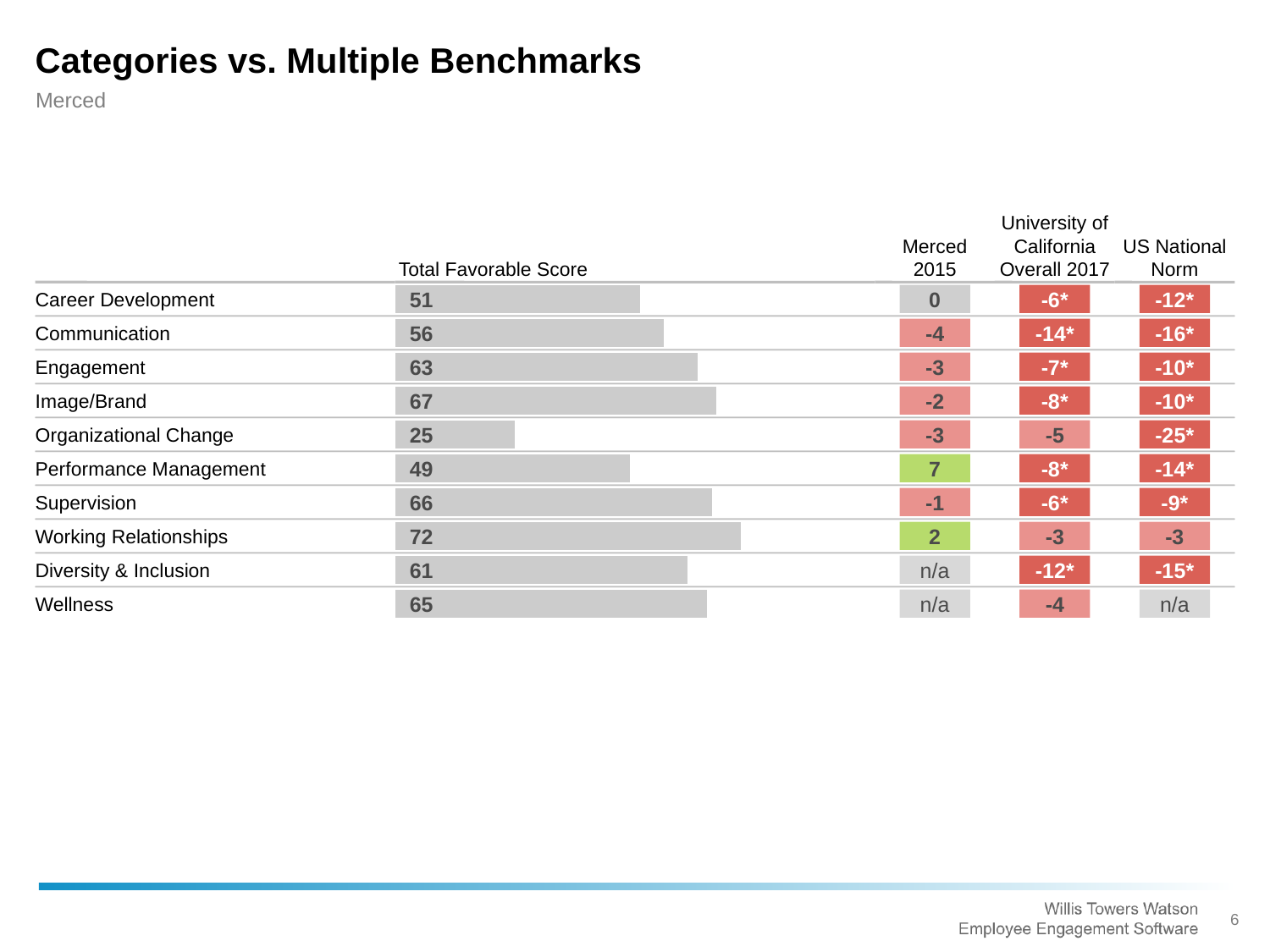
What is the value shown for Performance Management in the Merced 2015 column? 7 Which category has the lowest Total Favorable Score? Organizational Change What is the Total Favorable Score for Organizational Change? 25 What is the value shown for Organizational Change in the US National Norm column? -25* What is the title of the slide? Categories vs. Multiple Benchmarks What kind of chart is used to show the Total Favorable Score? Bar chart What is the value shown for Communication in the University of California Overall 2017 column? -14* How many categories are listed in the Total Favorable Score chart? 10 Which category has the highest Total Favorable Score? Working Relationships What is the Total Favorable Score for Working Relationships? 72 Which has a higher Total Favorable Score, Engagement or Communication? Engagement What is the difference between the Total Favorable Scores for Image/Brand and Career Development? 16